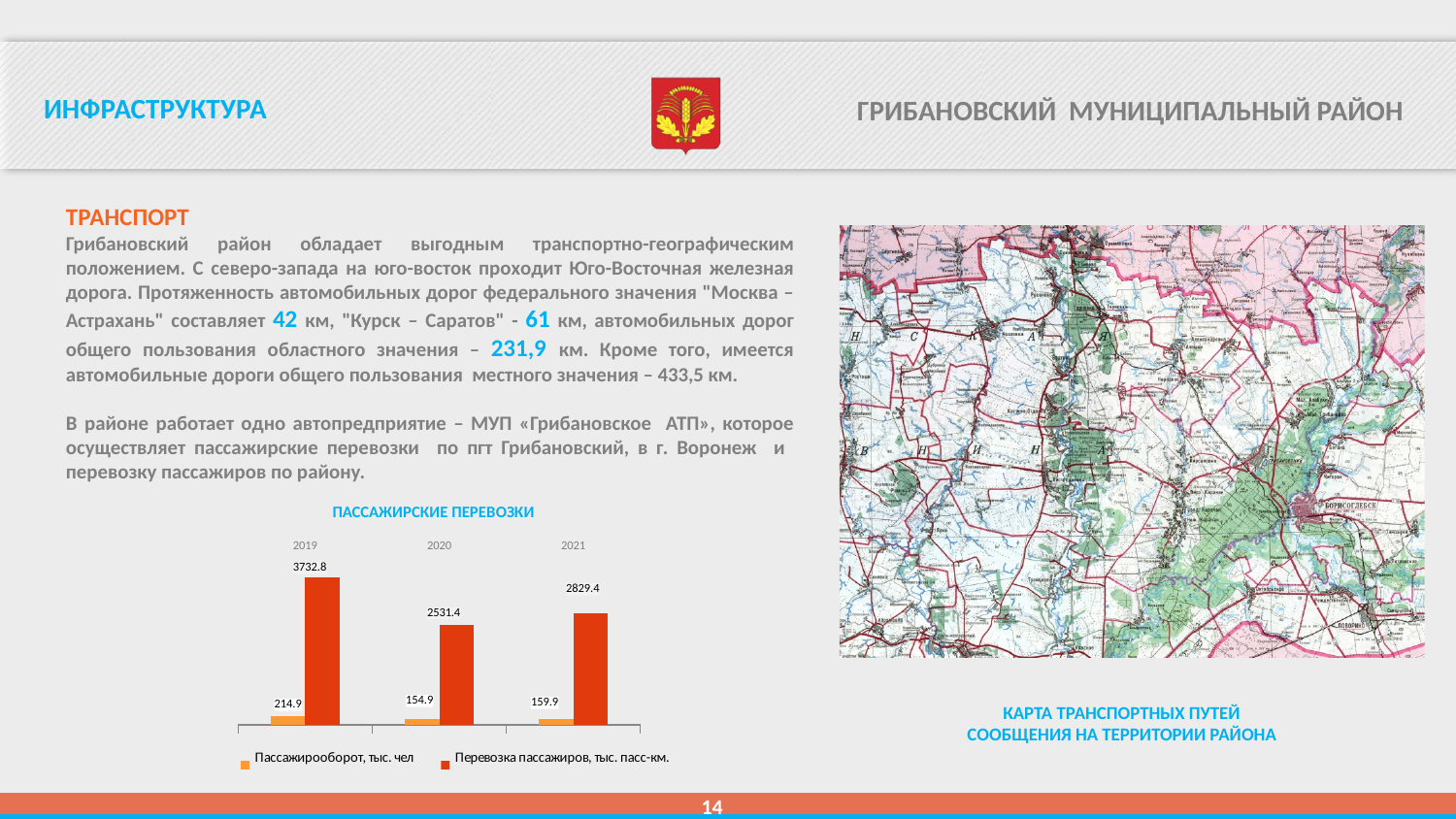
How many series does the legend of the ПАССАЖИРСКИЕ ПЕРЕВОЗКИ chart list? 2 What is the value of the red series (Перевозка пассажиров, тыс. пасс-км.) for 2019? 3732.8 What kind of chart is shown under the heading ПАССАЖИРСКИЕ ПЕРЕВОЗКИ? bar chart In which year is the light orange series (Пассажирооборот) lowest? 2020 In which year is the red series (Перевозка пассажиров) highest? 2019 What is the value of the red series (Перевозка пассажиров, тыс. пасс-км.) for 2021? 2829.4 Does the red series (Перевозка пассажиров) rise or fall from 2019 to 2020? fall Which is larger for the light orange series (Пассажирооборот): the 2019 value or the 2021 value? 2019 What is the value of the light orange series (Пассажирооборот, тыс. чел) for 2020? 154.9 What is the title of the chart on the slide? ПАССАЖИРСКИЕ ПЕРЕВОЗКИ How many years are shown on the x axis of the ПАССАЖИРСКИЕ ПЕРЕВОЗКИ chart? 3 What is the difference between the red series values for 2019 and 2020? 1201.4